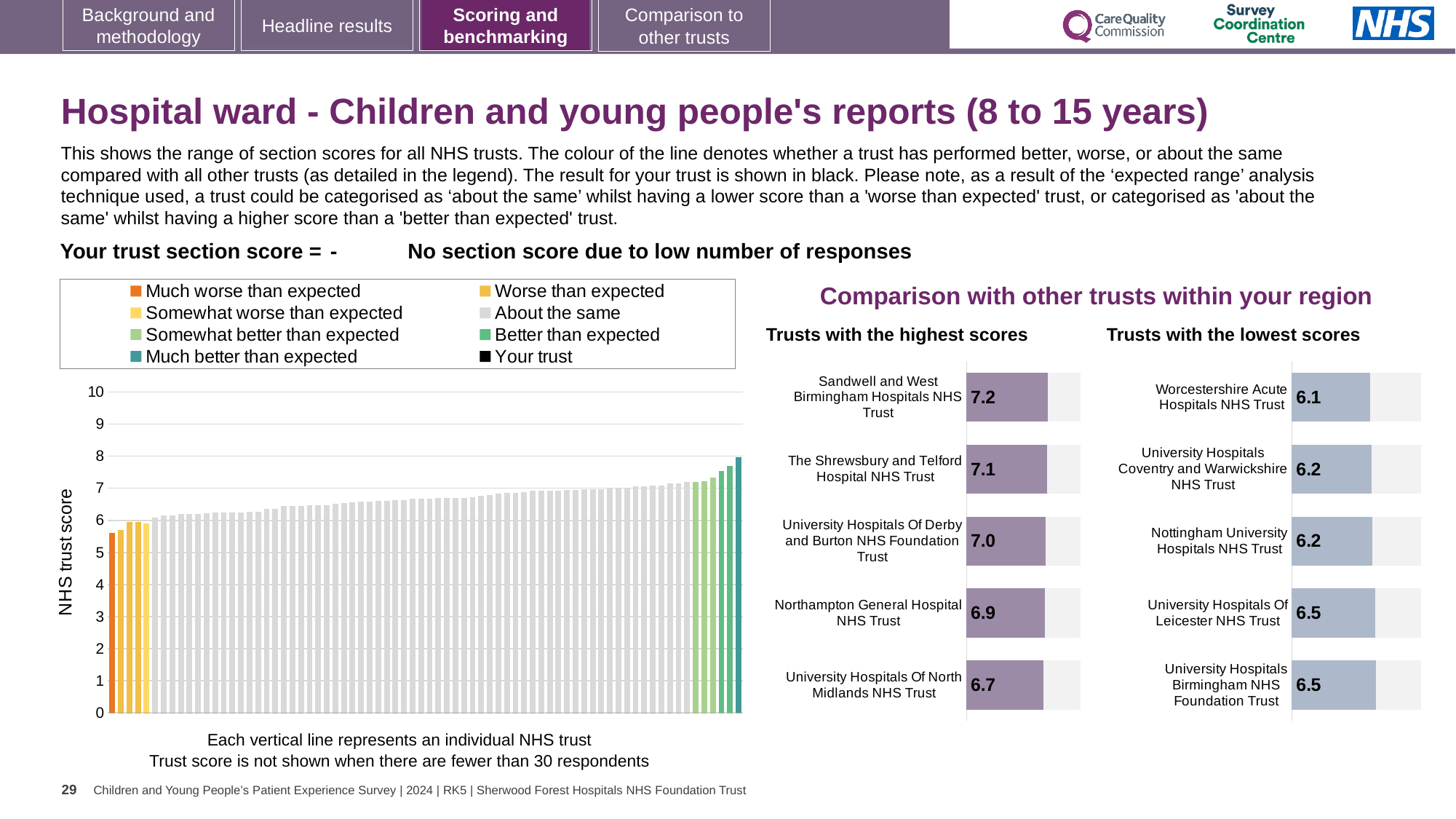
In the 'Trusts with the highest scores' chart, which trust has the highest score? Sandwell and West Birmingham Hospitals NHS Trust In the 'Trusts with the lowest scores' chart, what is the score for Worcestershire Acute Hospitals NHS Trust? 6.1 How many entries does the legend above the 'NHS trust score' chart list? 8 In the 'Trusts with the highest scores' chart, what is the difference between the scores of Sandwell and West Birmingham Hospitals NHS Trust and University Hospitals Of North Midlands NHS Trust? 0.5 In the 'Trusts with the highest scores' chart, what is the score for Northampton General Hospital NHS Trust? 6.9 In the 'NHS trust score' chart on the left, do the bar values rise or fall from left to right? rise In the 'Trusts with the lowest scores' chart, how many trusts are listed? 5 In the 'Trusts with the lowest scores' chart, what is the score for University Hospitals Of Leicester NHS Trust? 6.5 In the 'Trusts with the highest scores' chart, which trust has the lowest score? University Hospitals Of North Midlands NHS Trust In the 'Trusts with the lowest scores' chart, which has the higher score: Nottingham University Hospitals NHS Trust or University Hospitals Of Leicester NHS Trust? University Hospitals Of Leicester NHS Trust What kind of chart is the 'NHS trust score' chart on the left of the slide? bar chart In the 'Trusts with the highest scores' chart, what is the score for Sandwell and West Birmingham Hospitals NHS Trust? 7.2